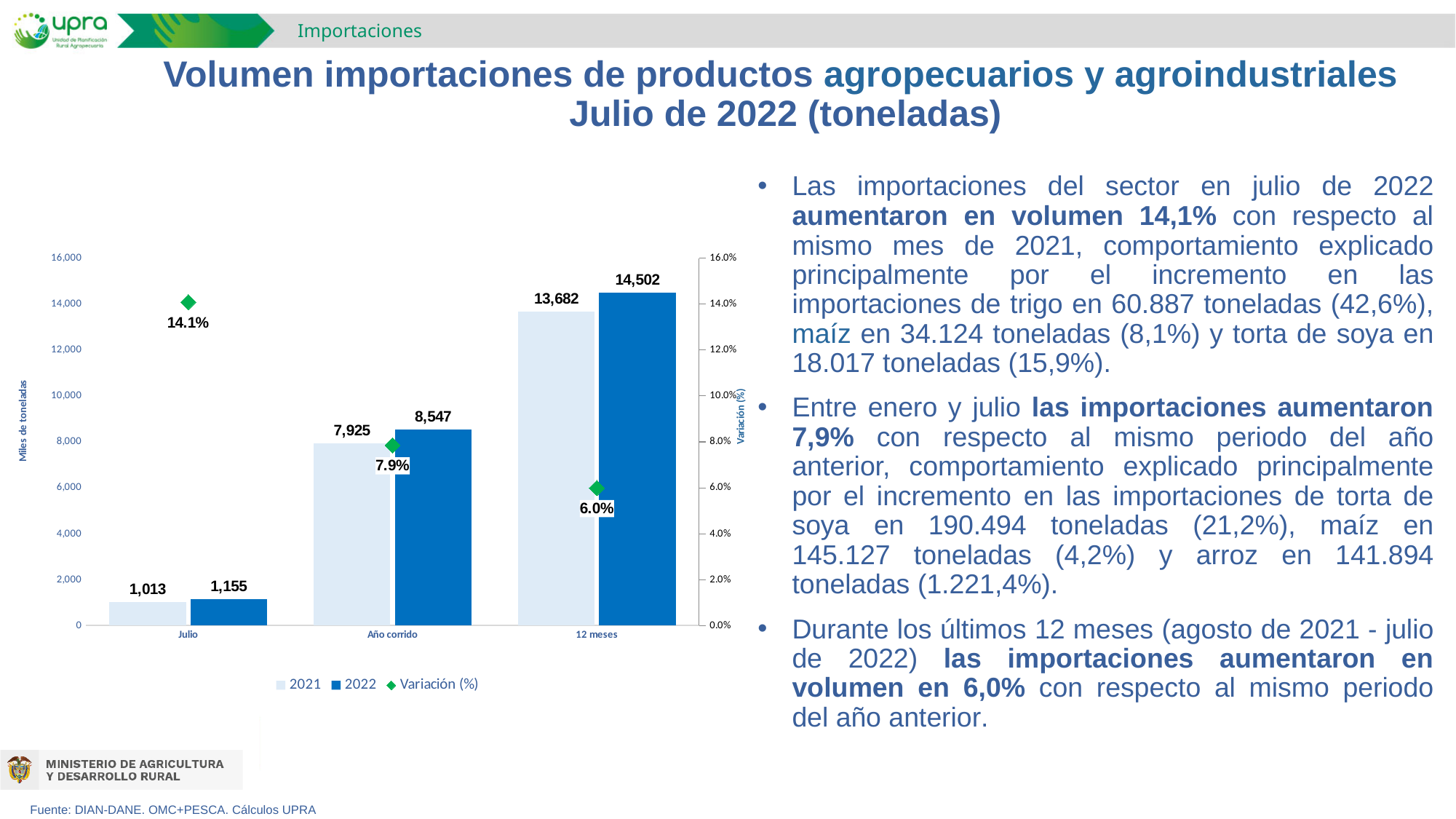
Which category has the lowest 2021 value? Julio What is the difference between the 2022 and 2021 values for 12 meses? 820 How many series does the legend list? 3 What is the Variación (%) value for 12 meses? 6.0% Which category has the highest Variación (%)? Julio What is the difference between the 2022 and 2021 values for Año corrido? 622 What is the 2022 value for Julio? 1,155 Which is larger for Julio, the 2021 value or the 2022 value? 2022 What is the label of the left vertical axis? Miles de toneladas What is the 2021 value for Año corrido? 7,925 What is the 2022 value for 12 meses? 14,502 How many categories are shown on the x axis? 3